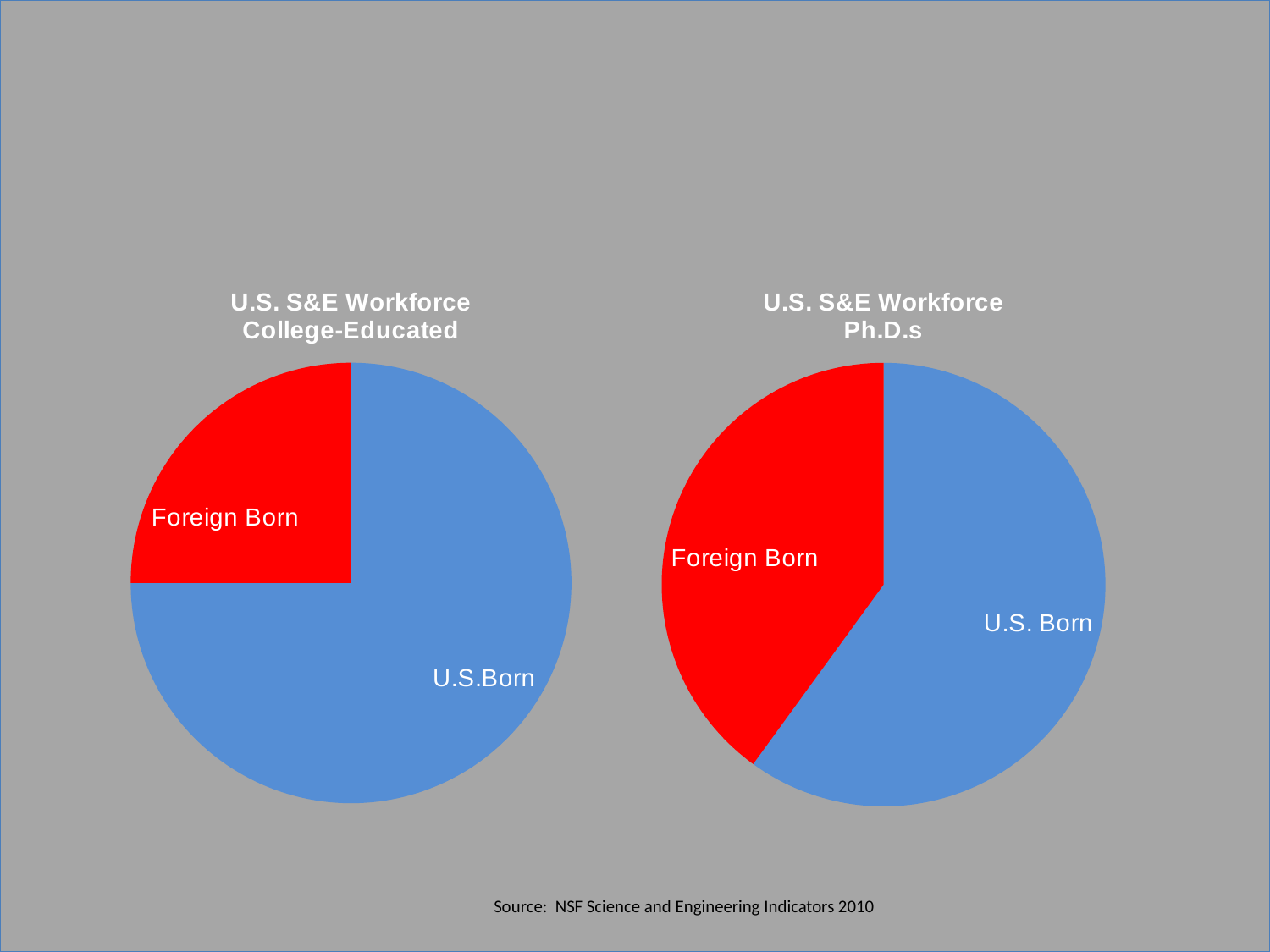
In the "U.S. S&E Workforce Ph.D.s" chart, which slice is the smallest? Foreign Born What kind of chart is the "U.S. S&E Workforce College-Educated" chart? pie chart In the "U.S. S&E Workforce Ph.D.s" chart, which slice is the largest? U.S. Born What colour is the Foreign Born slice in the "U.S. S&E Workforce Ph.D.s" chart? red Which chart has the larger Foreign Born share, the College-Educated chart or the Ph.D.s chart? Ph.D.s In the "U.S. S&E Workforce College-Educated" chart, which slice is the largest? U.S. Born What kind of chart is the "U.S. S&E Workforce Ph.D.s" chart? pie chart How many slices does the "U.S. S&E Workforce College-Educated" pie chart have? 2 What is the title of the pie chart on the left of the slide? U.S. S&E Workforce College-Educated In the "U.S. S&E Workforce Ph.D.s" chart, which is larger, the Foreign Born slice or the U.S. Born slice? U.S. Born In the "U.S. S&E Workforce College-Educated" chart, which slice is the smallest? Foreign Born How many slices does the "U.S. S&E Workforce Ph.D.s" pie chart have? 2